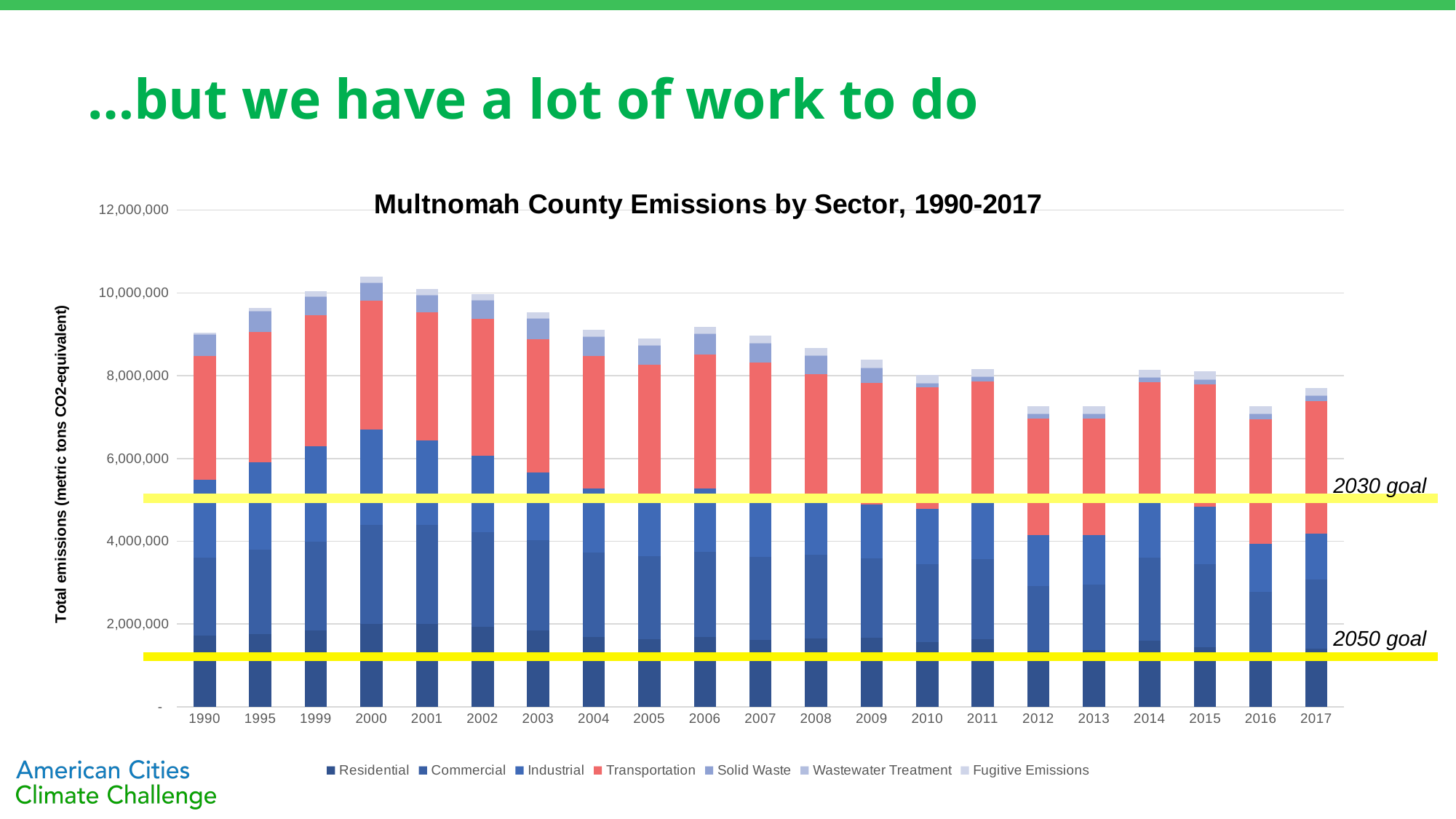
What kind of chart is shown on the slide? Stacked bar chart Is the total emissions value for 2012 greater or less than 8,000,000? less Is the total emissions value for 2017 greater or less than 8,000,000? less What are the two goal lines drawn across the chart labelled? 2030 goal and 2050 goal Do total emissions generally rise or fall from 2000 to 2017? fall Which year has higher total emissions, 1990 or 2017? 1990 Is the total emissions value for 2000 greater or less than 10,000,000? greater Which year has the highest total emissions? 2000 How many series does the legend list? 7 How many years are shown along the x axis? 21 What is the title of the chart? Multnomah County Emissions by Sector, 1990-2017